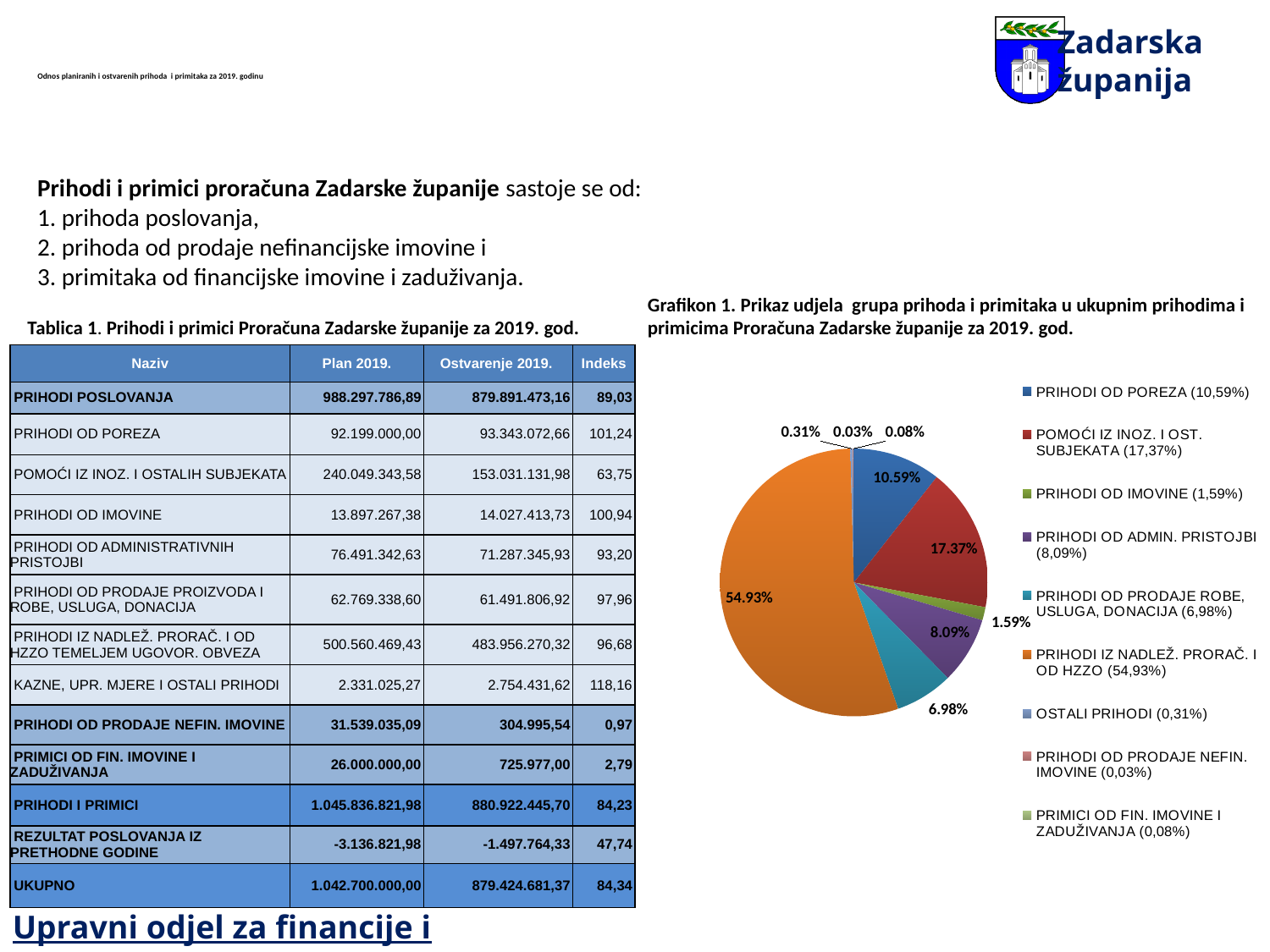
In the pie chart, what is the difference in percentage points between the share for POMOĆI IZ INOZ. I OST. SUBJEKATA and the share for PRIHODI OD POREZA? 6.78 In the pie chart, what share is shown for POMOĆI IZ INOZ. I OST. SUBJEKATA? 17.37% In the pie chart, what share is shown for PRIHODI OD PRODAJE NEFIN. IMOVINE? 0.03% In the pie chart, which is larger: the share for PRIHODI OD POREZA or the share for PRIHODI OD ADMIN. PRISTOJBI? PRIHODI OD POREZA Which category has the largest slice in the pie chart? PRIHODI IZ NADLEŽ. PRORAČ. I OD HZZO Which category has the smallest slice in the pie chart? PRIHODI OD PRODAJE NEFIN. IMOVINE In the pie chart, what share is shown for PRIHODI OD ADMIN. PRISTOJBI? 8.09% How many slices does the pie chart have? 9 How many entries does the legend of the pie chart list? 9 In the pie chart, what share is shown for PRIHODI IZ NADLEŽ. PRORAČ. I OD HZZO? 54.93% What kind of chart is Grafikon 1 on the slide? pie chart In the pie chart, what share is shown for PRIHODI OD POREZA? 10.59%